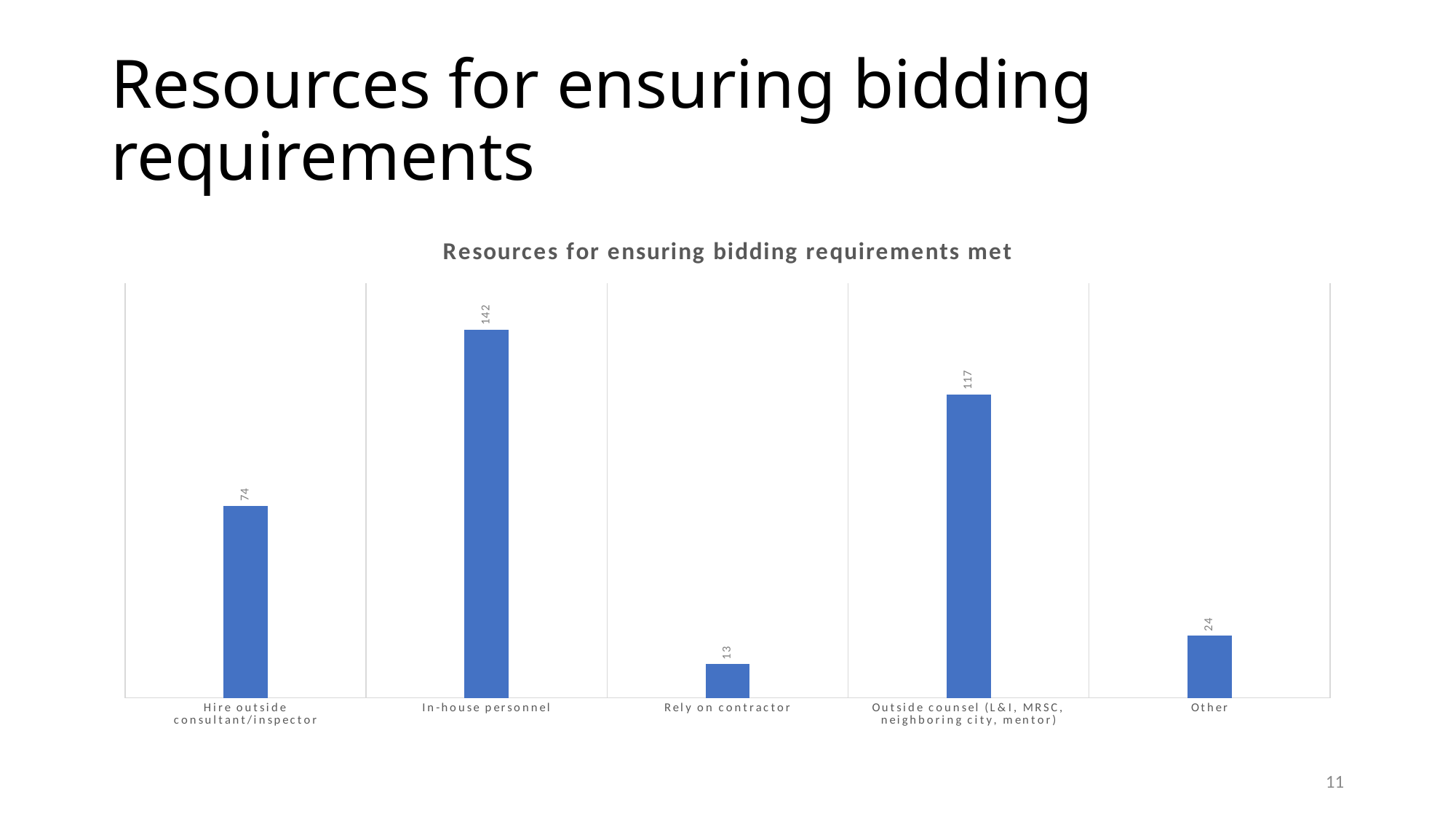
Which is larger, the value for Hire outside consultant/inspector or the value for Other? Hire outside consultant/inspector What is the value for Other? 24 What is the value for Rely on contractor? 13 Which category has the highest value? In-house personnel What kind of chart is shown on the slide? Bar chart How many categories are shown in the chart? 5 Which category has the lowest value? Rely on contractor What is the title of the chart? Resources for ensuring bidding requirements met What is the difference between the values for In-house personnel and Outside counsel (L&I, MRSC, neighboring city, mentor)? 25 What is the value for In-house personnel? 142 What is the value for Outside counsel (L&I, MRSC, neighboring city, mentor)? 117 What is the value for Hire outside consultant/inspector? 74